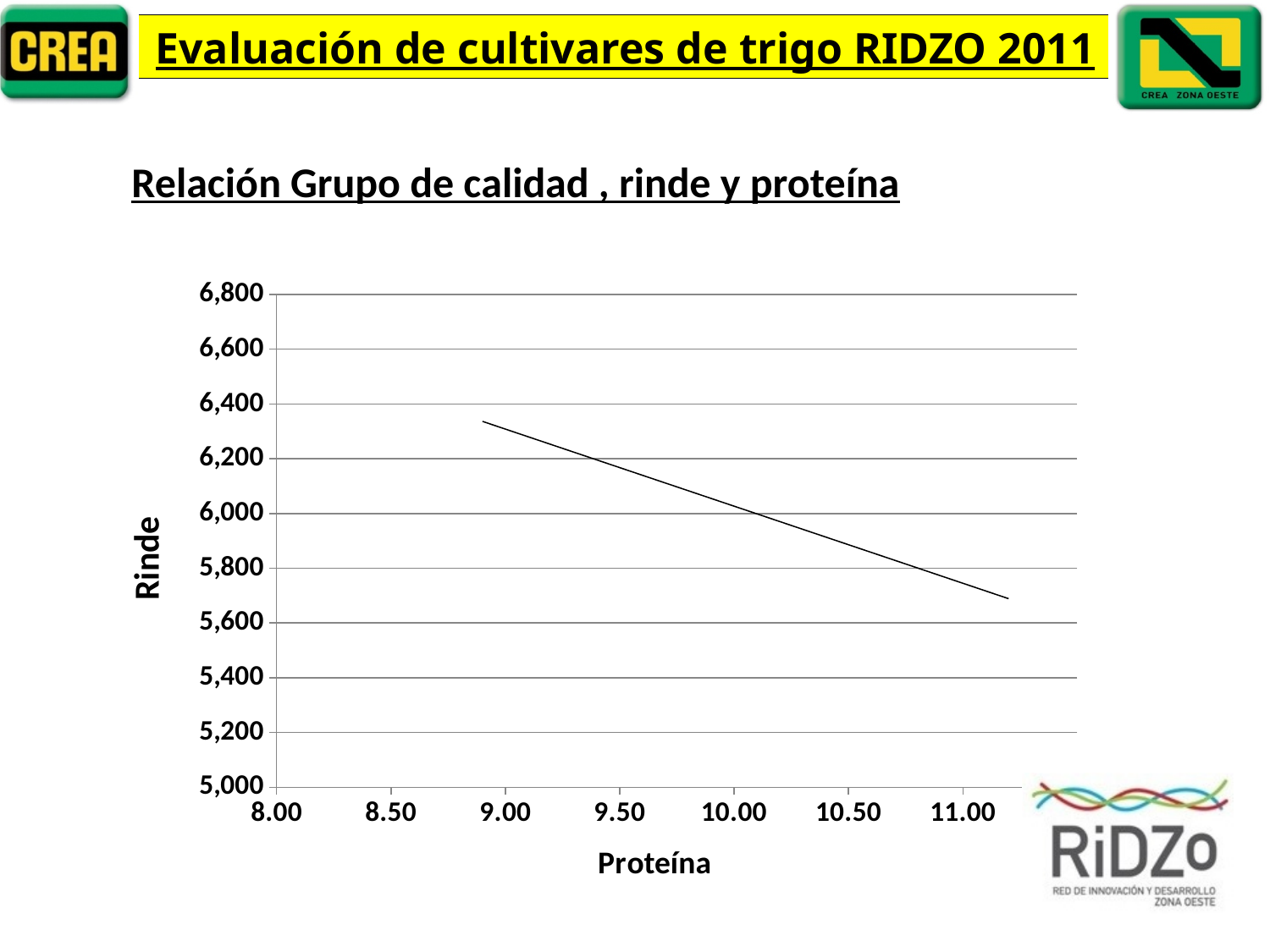
Is the Rinde value at a Proteína of 11.00 greater or less than 6,000? less What is the label of the y axis? Rinde Is the Rinde value at a Proteína of 10.50 greater or less than 6,200? less What kind of chart is shown on the slide? line chart As Proteína increases along the x axis, does Rinde rise or fall? fall Is the Rinde value at a Proteína of 9.00 greater or less than 6,400? less What is the label of the x axis? Proteína What is the highest value shown on the y axis? 6,800